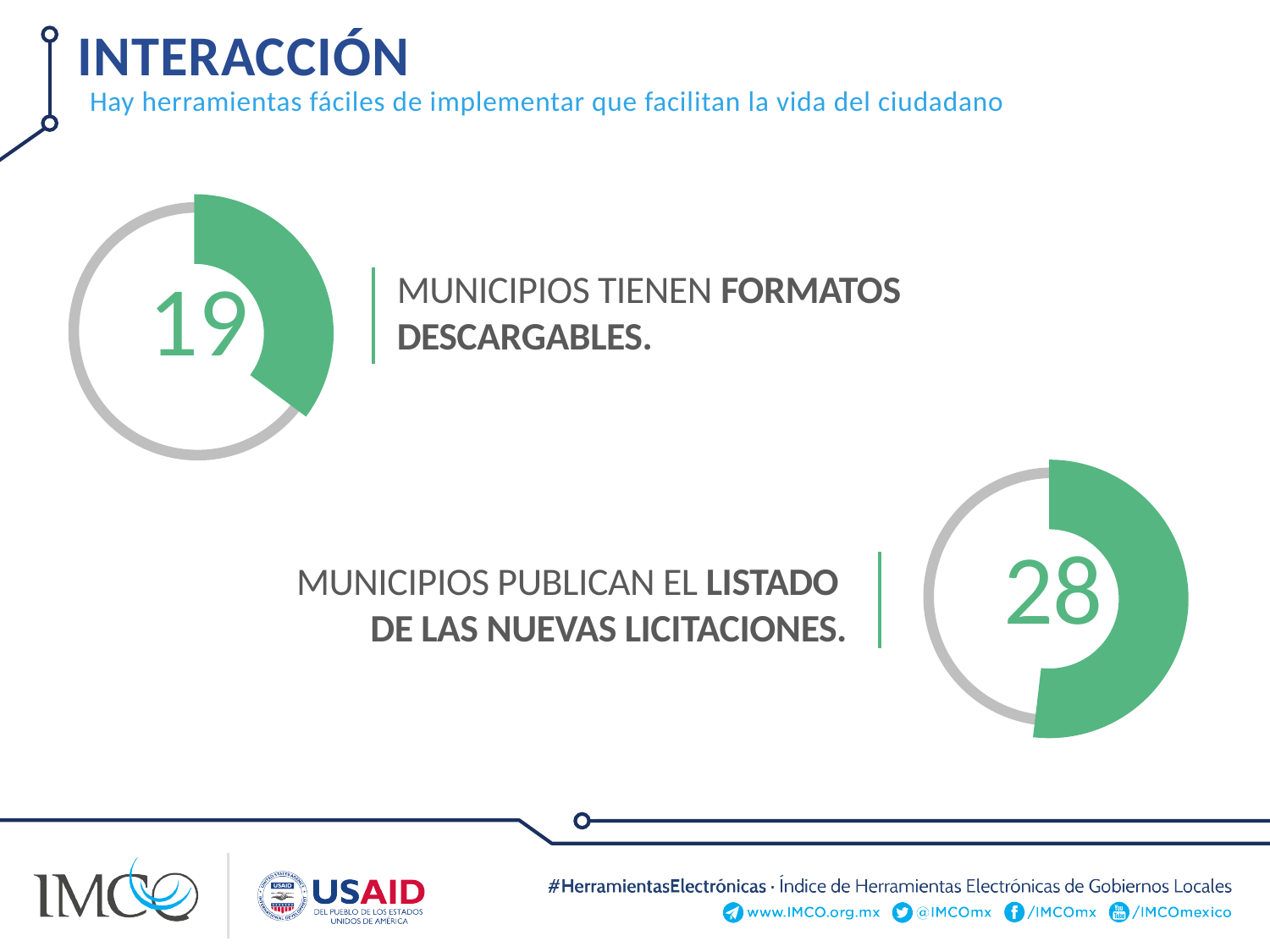
Is the value shown in the upper-left donut chart greater or less than 20? less What colour is the filled portion of the donut charts? Green Which is larger: the number of municipalities with downloadable forms or the number publishing the list of new tenders? Publishing the list of new tenders (28) What is the title of the slide containing the two donut charts? INTERACCIÓN How many municipalities have downloadable forms (formatos descargables), according to the upper-left donut chart? 19 How many donut charts are shown on the slide? 2 What is the difference between the number of municipalities publishing the list of new tenders and the number with downloadable forms? 9 Is the value shown in the lower-right donut chart greater or less than 20? greater How many municipalities publish the list of new tenders (listado de las nuevas licitaciones), according to the lower-right donut chart? 28 What kind of chart is used to show the number 19 on the slide? Donut (ring) chart Which of the two donut charts has the larger filled (green) portion? The lower-right chart (28)